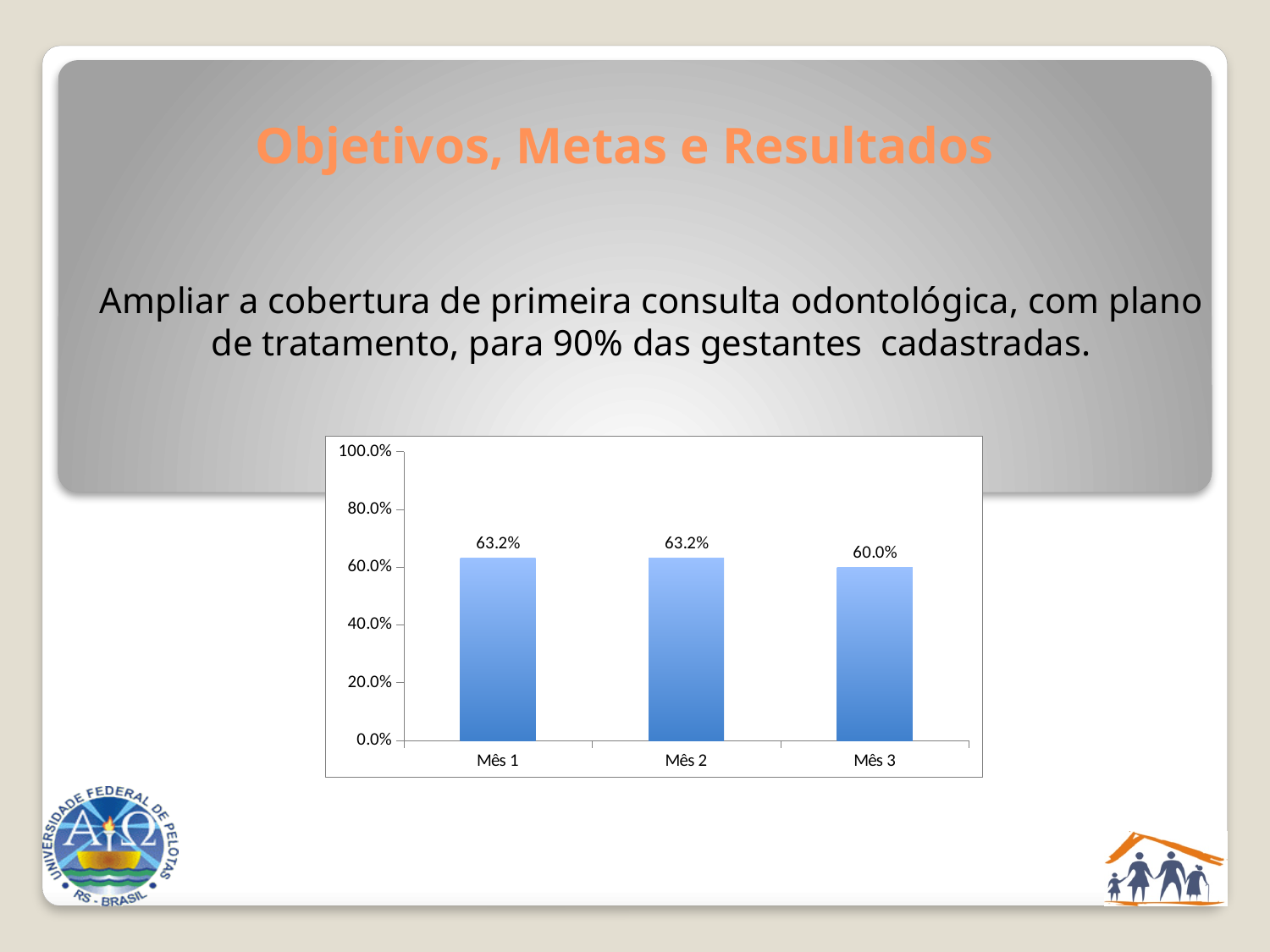
What is the value for Mês 3? 60.0% How many categories are shown on the x axis? 3 Which category has the lowest value? Mês 3 Which is larger, the value for Mês 2 or the value for Mês 3? Mês 2 What is the value for Mês 2? 63.2% Is the value for Mês 3 greater or less than 80.0%? less Do the values rise or fall from Mês 2 to Mês 3? fall Is the value for Mês 1 greater or less than 40.0%? greater What is the difference between the values for Mês 1 and Mês 3? 3.2% What kind of chart is shown on the slide? bar chart What is the highest tick value shown on the y axis? 100.0% What is the value for Mês 1? 63.2%